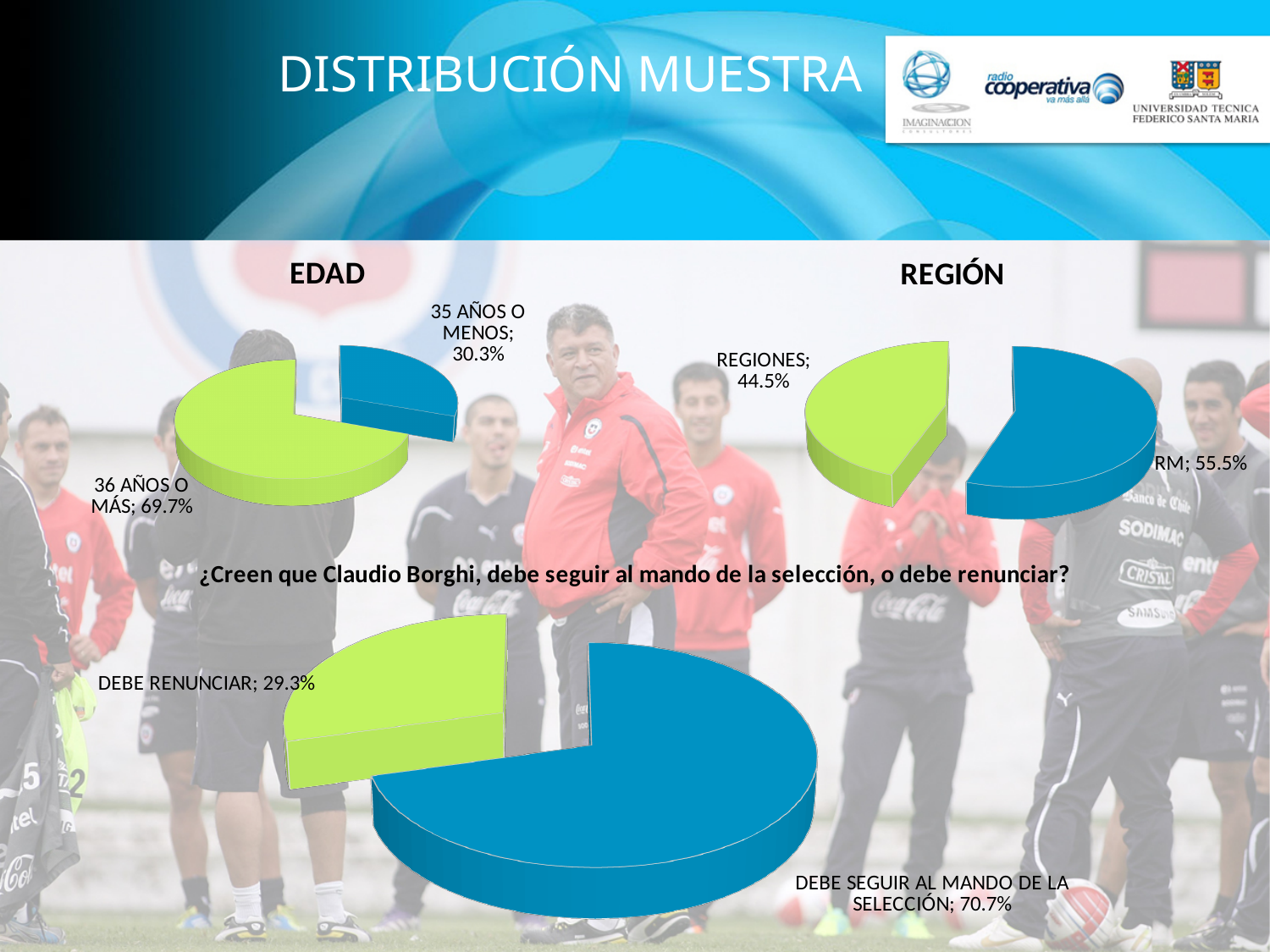
In the EDAD chart, what share is shown for 35 AÑOS O MENOS? 30.3% In the REGIÓN chart, what share is shown for RM? 55.5% What kind of chart is the EDAD chart? Pie chart In the bottom chart about Claudio Borghi, what share is shown for DEBE RENUNCIAR? 29.3% In the EDAD chart, what share is shown for 36 AÑOS O MÁS? 69.7% In the REGIÓN chart, what share is shown for REGIONES? 44.5% In the bottom chart about Claudio Borghi, what share is shown for DEBE SEGUIR AL MANDO DE LA SELECCIÓN? 70.7% How many slices does the REGIÓN chart have? 2 In the EDAD chart, which category has the largest slice? 36 AÑOS O MÁS In the REGIÓN chart, which category has the smaller slice? REGIONES In the REGIÓN chart, what is the difference in percentage points between RM and REGIONES? 11 percentage points In the bottom chart about Claudio Borghi, which is larger: DEBE RENUNCIAR or DEBE SEGUIR AL MANDO DE LA SELECCIÓN? DEBE SEGUIR AL MANDO DE LA SELECCIÓN